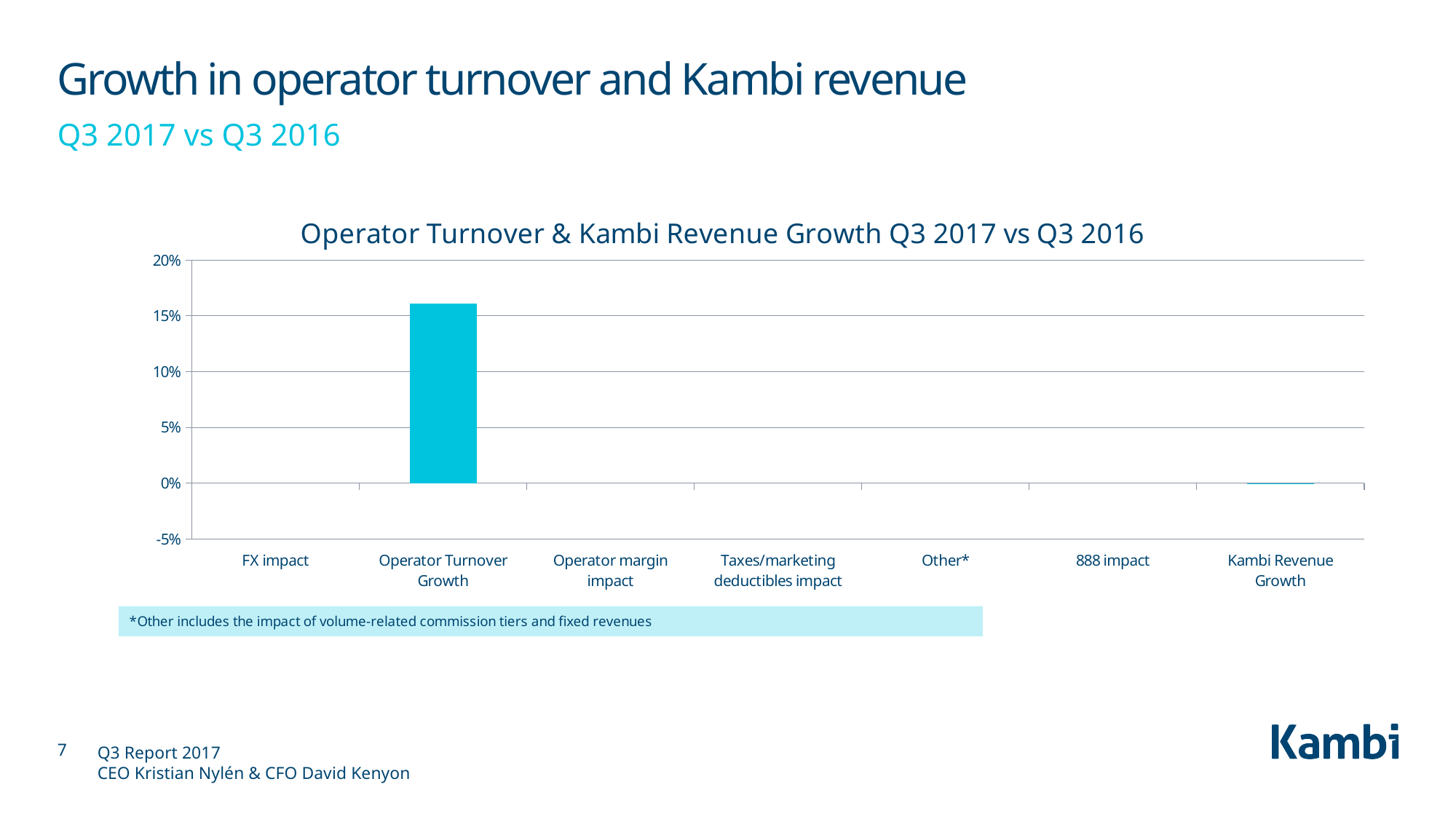
Which category has the highest value in the chart? Operator Turnover Growth What kind of chart is shown on the slide? Bar chart What is the lowest value shown on the chart's y axis? -5% What is the title of the chart? Operator Turnover & Kambi Revenue Growth Q3 2017 vs Q3 2016 Is the value for Operator Turnover Growth greater or less than 20%? less What is the label of the last category on the x axis? Kambi Revenue Growth Which is larger, the value for Operator Turnover Growth or the value for Kambi Revenue Growth? Operator Turnover Growth How many categories are shown on the x axis of the chart? 7 Is the value for Operator Turnover Growth greater or less than 10%? greater Is the value for Operator Turnover Growth greater or less than 15%? greater